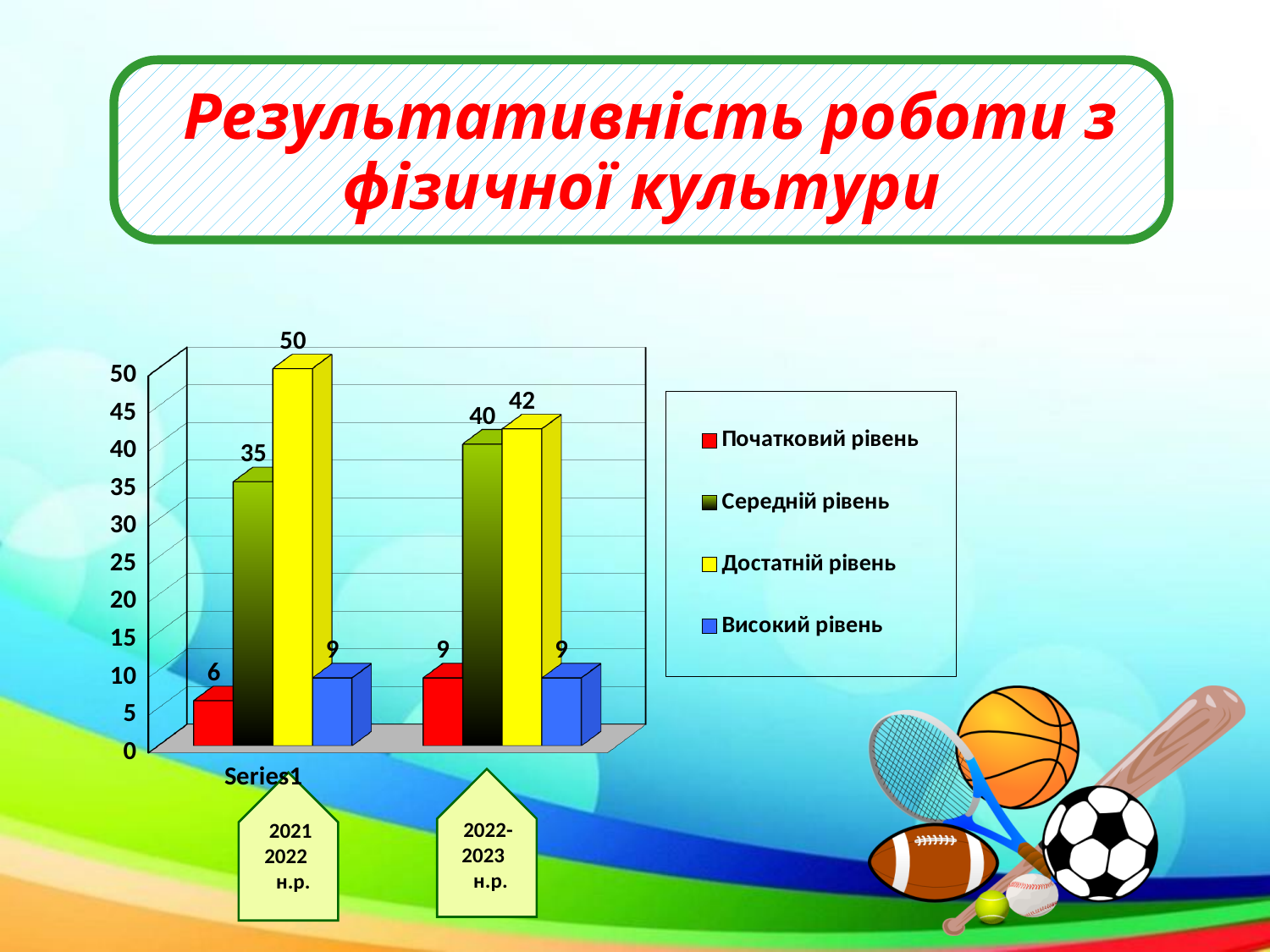
What colour represents Високий рівень in the legend? Blue Which level has the lowest value in the 2021-2022 н.р. group? Початковий рівень What is the difference between the Достатній рівень values for 2021-2022 н.р. and 2022-2023 н.р.? 8 What is the value for Достатній рівень in the 2021-2022 н.р. group? 50 What is the value for Високий рівень in the 2021-2022 н.р. group? 9 What is the value for Початковий рівень in the 2022-2023 н.р. group? 9 Which is larger: Середній рівень in 2021-2022 н.р. or Середній рівень in 2022-2023 н.р.? 2022-2023 н.р. What kind of chart is shown on the slide? Bar chart Which level has the highest value in the 2021-2022 н.р. group? Достатній рівень How many series does the legend list? 4 What is the value for Середній рівень in the 2022-2023 н.р. group? 40 How many groups of bars are shown on the chart? 2